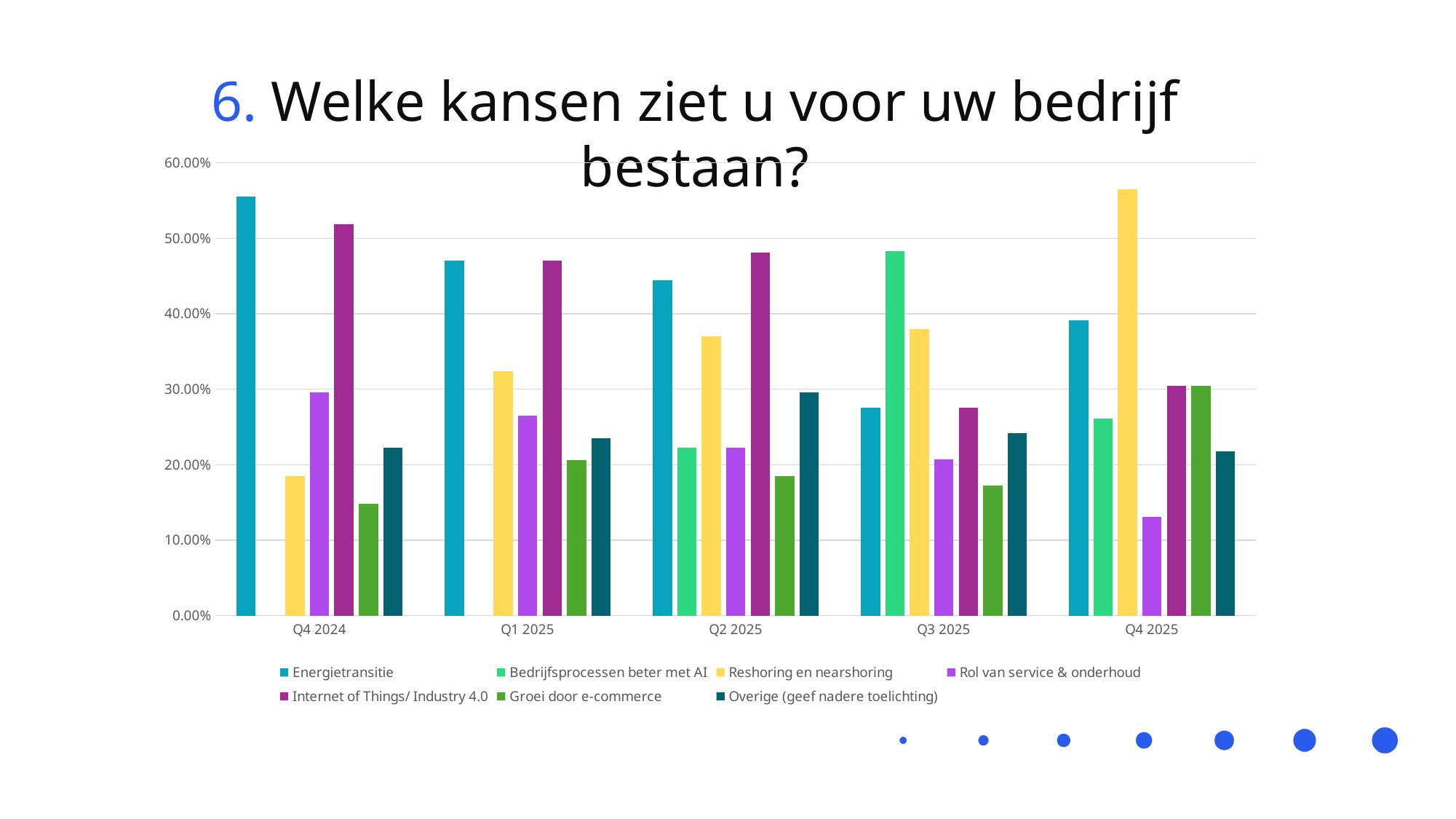
Which series has the highest value in Q3 2025? Bedrijfsprocessen beter met AI Is the value for Energietransitie in Q4 2024 greater or less than 50.00%? greater Which series has the highest value in Q4 2025? Reshoring en nearshoring Which series has the lowest value in Q4 2025? Rol van service & onderhoud In Q2 2025, which is larger: Reshoring en nearshoring or Overige (geef nadere toelichting)? Reshoring en nearshoring How many quarters are shown on the x axis? 5 Does the value for Energietransitie rise or fall from Q4 2024 to Q3 2025? fall What is the title of the chart? 6. Welke kansen ziet u voor uw bedrijf bestaan? How many series does the legend list? 7 Is the value for Reshoring en nearshoring in Q4 2025 greater or less than 50.00%? greater Is the value for Groei door e-commerce in Q4 2024 greater or less than 20.00%? less What kind of chart is shown on the slide? bar chart